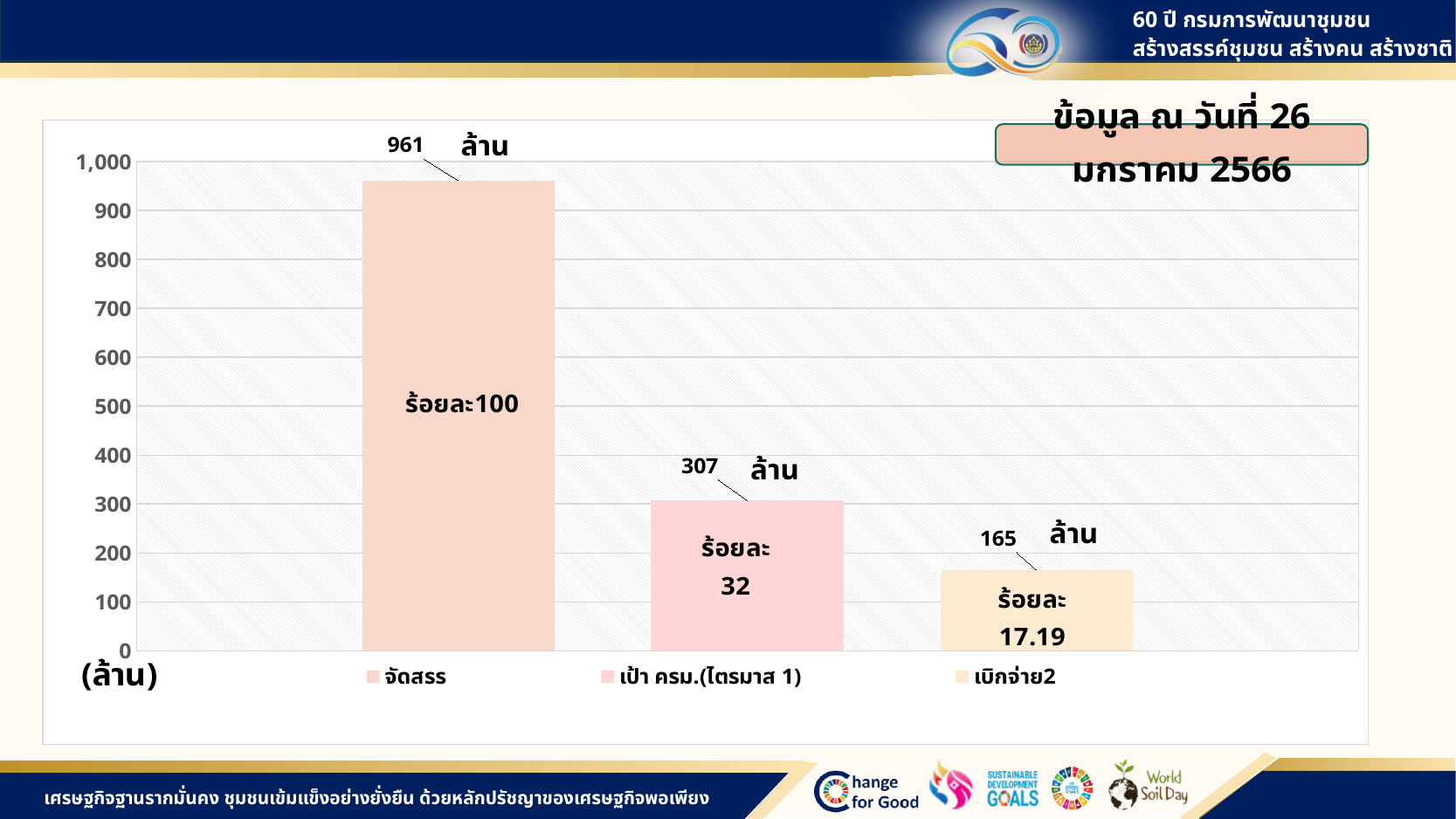
What percentage is printed inside the เบิกจ่าย2 bar? ร้อยละ 17.19 How many entries does the legend list? 3 What is the value for เบิกจ่าย2? 165 ล้าน Which category has the highest value? จัดสรร What is the difference between the values for เป้า ครม.(ไตรมาส 1) and เบิกจ่าย2? 142 ล้าน What percentage is printed inside the เป้า ครม.(ไตรมาส 1) bar? ร้อยละ 32 What is the difference between the values for จัดสรร and เป้า ครม.(ไตรมาส 1)? 654 ล้าน Which is larger, the value for เป้า ครม.(ไตรมาส 1) or the value for เบิกจ่าย2? เป้า ครม.(ไตรมาส 1) What is the value for เป้า ครม.(ไตรมาส 1)? 307 ล้าน What is the value for จัดสรร? 961 ล้าน Which category has the lowest value? เบิกจ่าย2 What kind of chart is shown on the slide? Bar chart